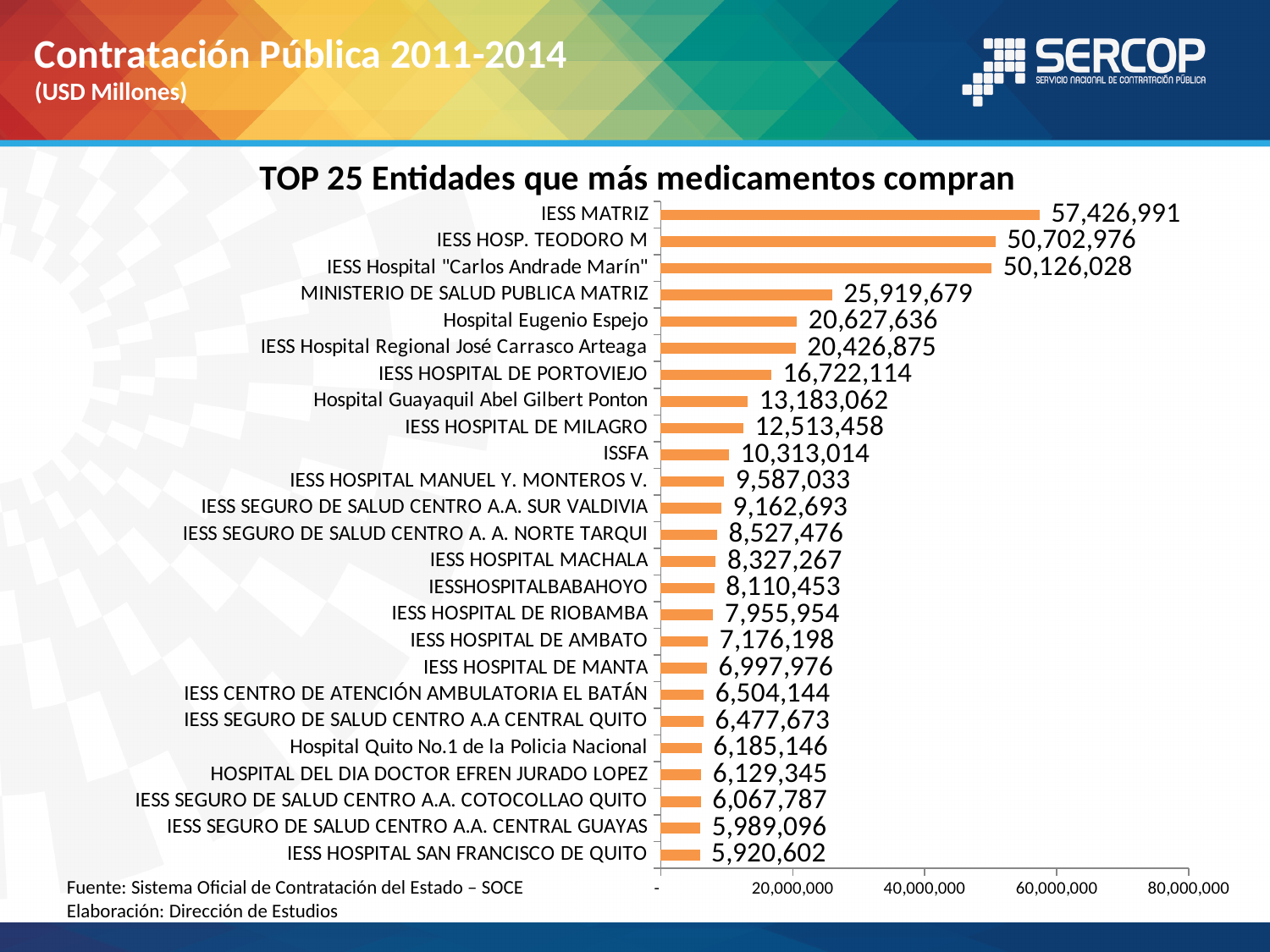
What is the value for IESS HOSPITAL SAN FRANCISCO DE QUITO? 5,920,602 What is the value for ISSFA? 10,313,014 Which entity has the highest value? IESS MATRIZ What is the title of the chart? TOP 25 Entidades que más medicamentos compran What is the difference between the values for IESS MATRIZ and IESS HOSP. TEODORO M? 6,724,015 How many entities are shown in the chart? 25 Which entity has the lowest value? IESS HOSPITAL SAN FRANCISCO DE QUITO What is the value for MINISTERIO DE SALUD PUBLICA MATRIZ? 25,919,679 What is the value for IESS MATRIZ? 57,426,991 Is the value for IESS HOSPITAL DE PORTOVIEJO greater or less than 20,000,000? less What kind of chart is shown on the slide? bar chart Which is larger, the value for Hospital Eugenio Espejo or for IESS Hospital Regional José Carrasco Arteaga? Hospital Eugenio Espejo